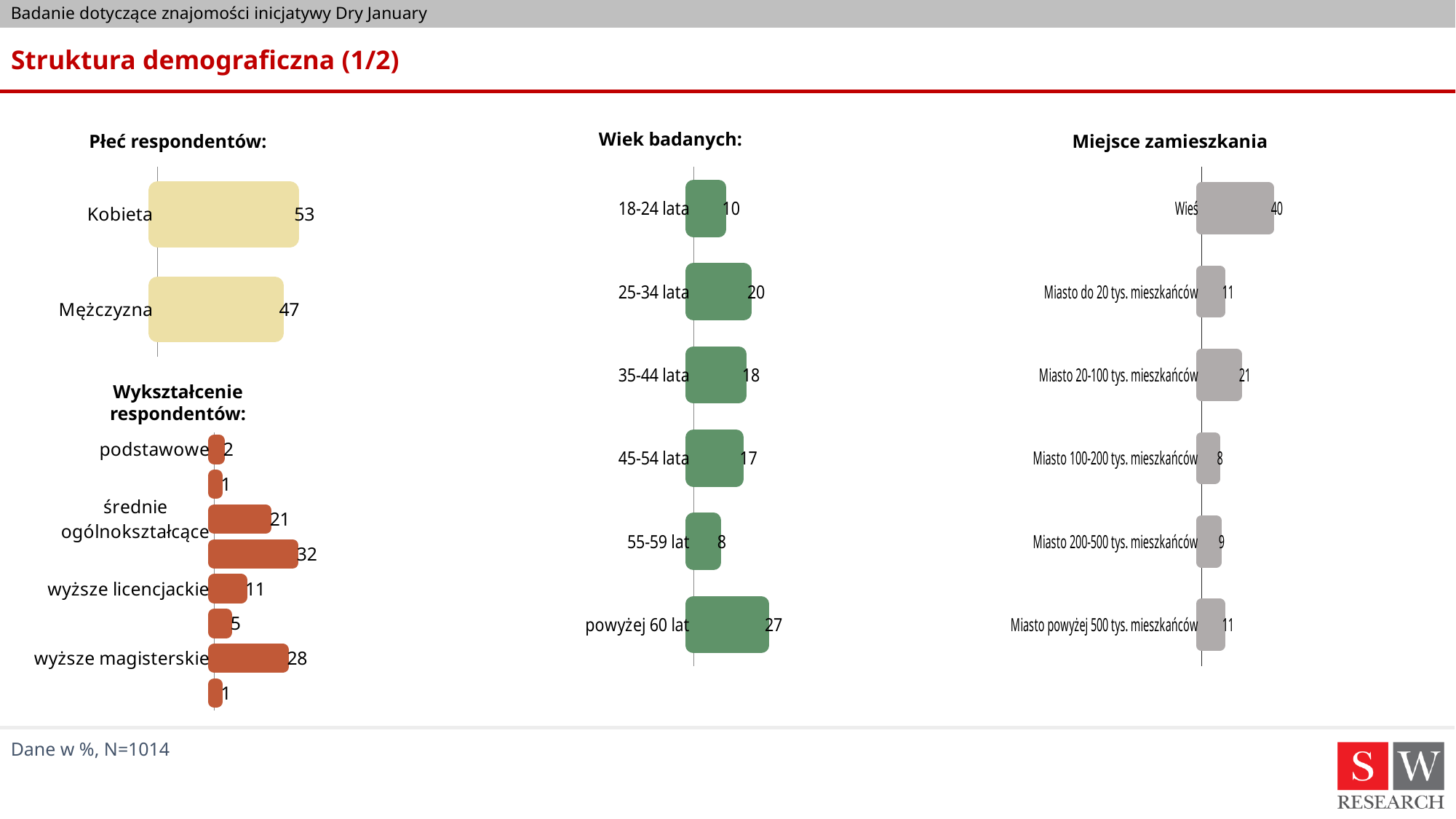
In the 'Wykształcenie respondentów' chart, what is the difference between the values for wyższe magisterskie and wyższe licencjackie? 17 In the 'Miejsce zamieszkania' chart, which is larger: Miasto 20-100 tys. mieszkańców or Miasto 200-500 tys. mieszkańców? Miasto 20-100 tys. mieszkańców In the 'Wiek badanych' chart, which age group has the lowest value? 55-59 lat How many age groups are shown in the 'Wiek badanych' chart? 6 In the 'Wiek badanych' chart, what is the value for 25-34 lata? 20 What type of chart is the 'Wiek badanych' chart? Bar chart In the 'Wykształcenie respondentów' chart, what is the value for wyższe magisterskie? 28 In the 'Miejsce zamieszkania' chart, what is the value for Wieś? 40 In the 'Płeć respondentów' chart, what is the difference between the values for Kobieta and Mężczyzna? 6 In the 'Płeć respondentów' chart, what is the value for Kobieta? 53 In the 'Miejsce zamieszkania' chart, which category has the lowest value? Miasto 100-200 tys. mieszkańców In the 'Wiek badanych' chart, which age group has the highest value? powyżej 60 lat